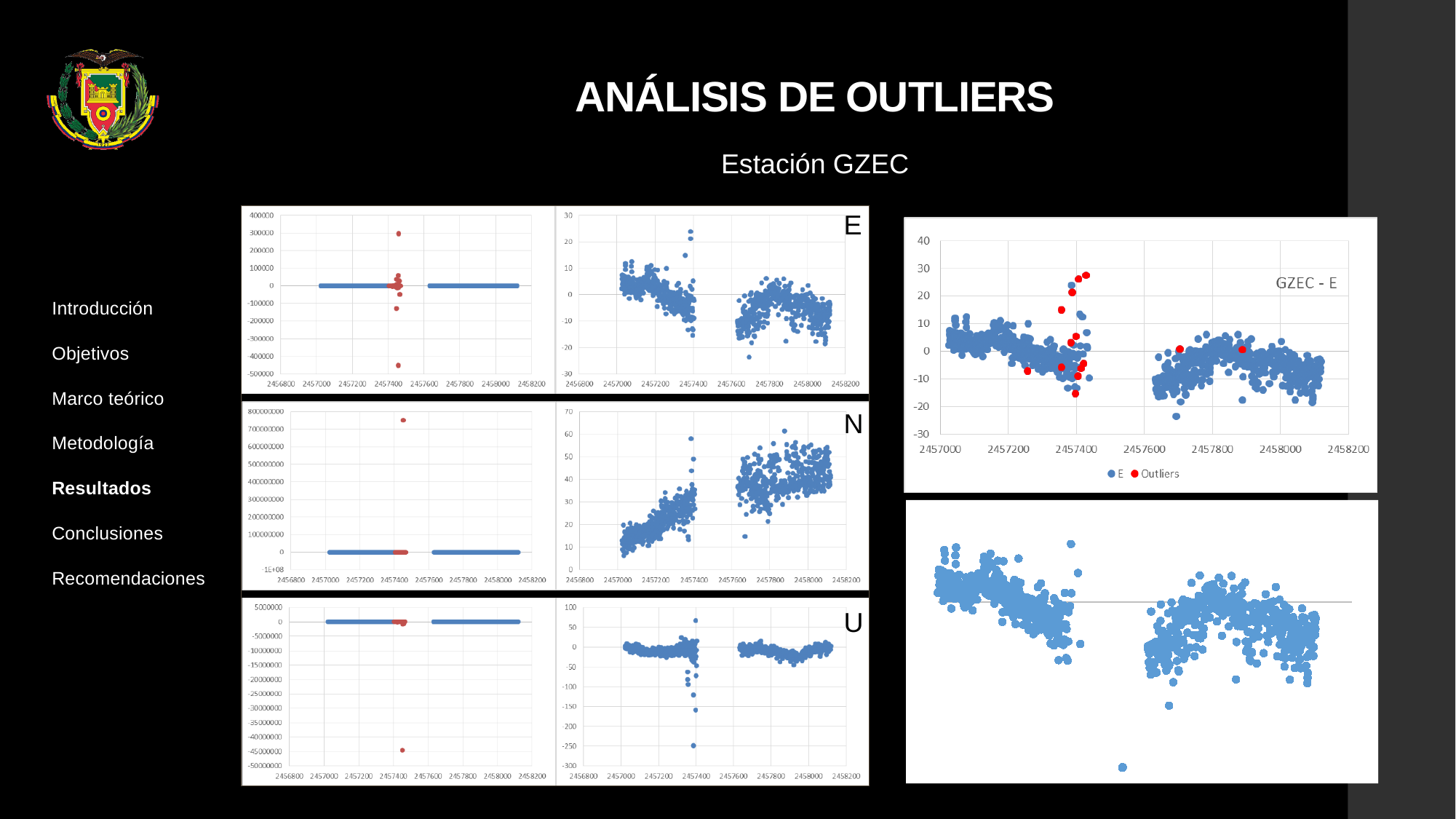
In the "GZEC - E" chart, what colour are the Outliers points? red What kind of chart is the "GZEC - E" chart on the right of the slide? scatter chart In the "GZEC - E" chart, is the highest red outlier point greater or less than 20? greater What are the two legend entries of the "GZEC - E" chart? E and Outliers In the chart labelled E (top row, right column of the left grid), do the values in the first cluster of points rise or fall along the x axis? fall In the chart labelled N (middle row, right column of the left grid), do the values generally rise or fall along the x axis? rise In the bottom-left chart of the left grid, what is the lowest value shown on the vertical axis? -50000000 In the top-left chart of the left grid, what is the highest value shown on the vertical axis? 400000 In the "GZEC - E" chart, what is the highest value shown on the vertical axis? 40 In the "GZEC - E" chart, is the lowest blue point (near x = 2457600) greater or less than -20? less How many series does the legend of the "GZEC - E" chart list? 2 In the "GZEC - E" chart, what is the lowest value shown on the vertical axis? -30